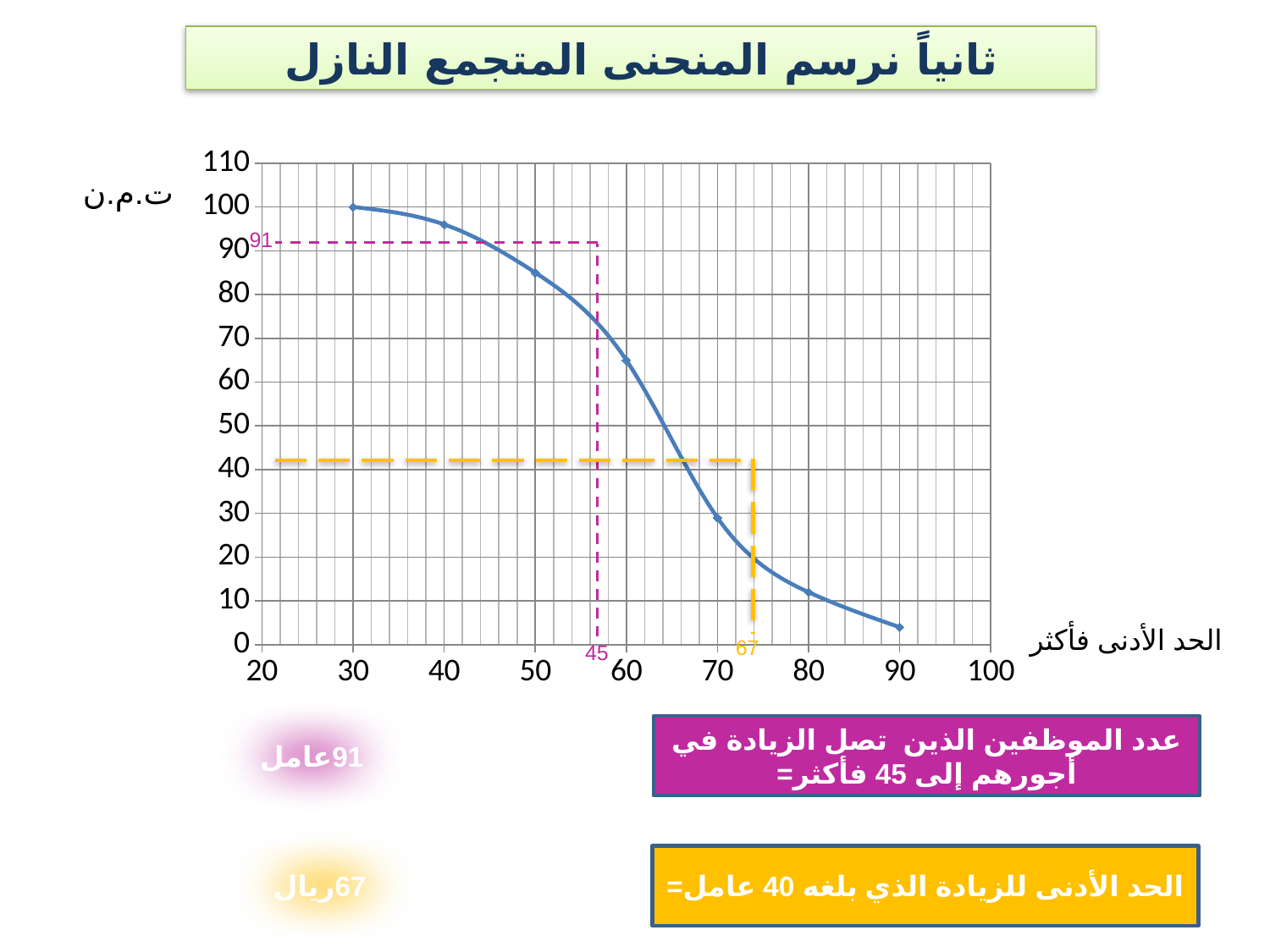
Which x value has the highest point on the curve, 30 or 80? 30 Is the value of the curve at x = 60 greater or less than 50? greater What value is written next to the pink dashed horizontal line on the y axis? 91 Is the value of the curve at x = 90 greater or less than 10? less What is the value of the curve at x = 30? 100 What value is written below the yellow dashed vertical line on the x axis? 67 Is the value of the curve at x = 50 greater or less than 80? greater What kind of chart is shown on the slide? line chart What is the highest tick value shown on the y axis? 110 How many data points are plotted on the curve? 7 Do the values on the curve rise or fall as the x axis increases from 30 to 90? fall